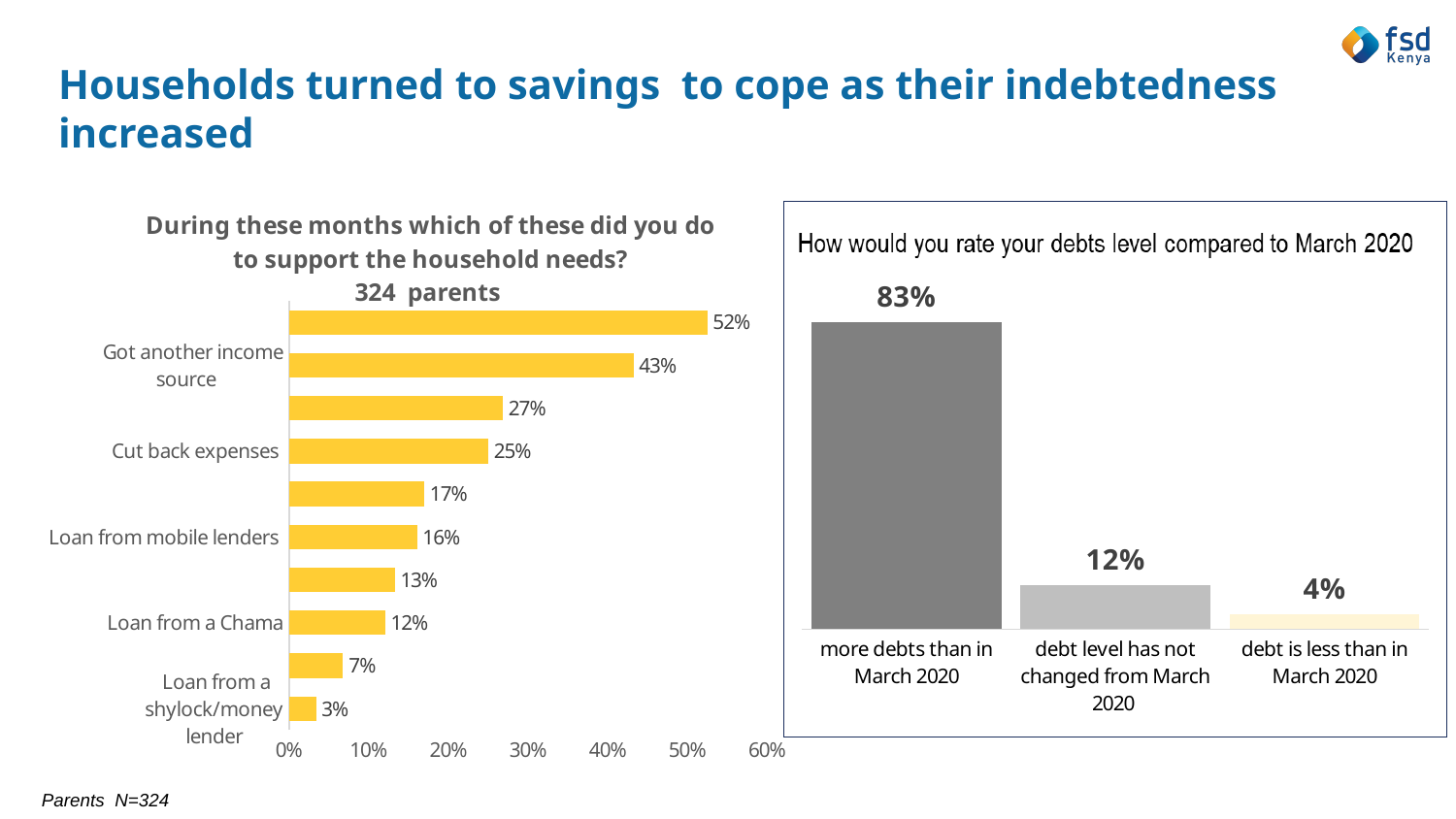
In the left chart, what percentage of parents said they got another income source? 43% In the left chart, what percentage of parents took a loan from mobile lenders? 16% In the right chart, which category has the highest value? more debts than in March 2020 In the left chart, what percentage of parents cut back expenses? 25% What type of chart is the left chart? Bar chart In the right chart, what percentage said their debt is less than in March 2020? 4% In the left chart, how many bars are plotted? 10 In the left chart, what is the difference between 'Got another income source' and 'Cut back expenses'? 18% In the right chart, what percentage of parents said they have more debts than in March 2020? 83% In the left chart, what percentage of parents took a loan from a Chama? 12% In the right chart, what is the difference between 'debt level has not changed from March 2020' and 'debt is less than in March 2020'? 8% In the left chart, which labelled category has the lowest value? Loan from a shylock/money lender